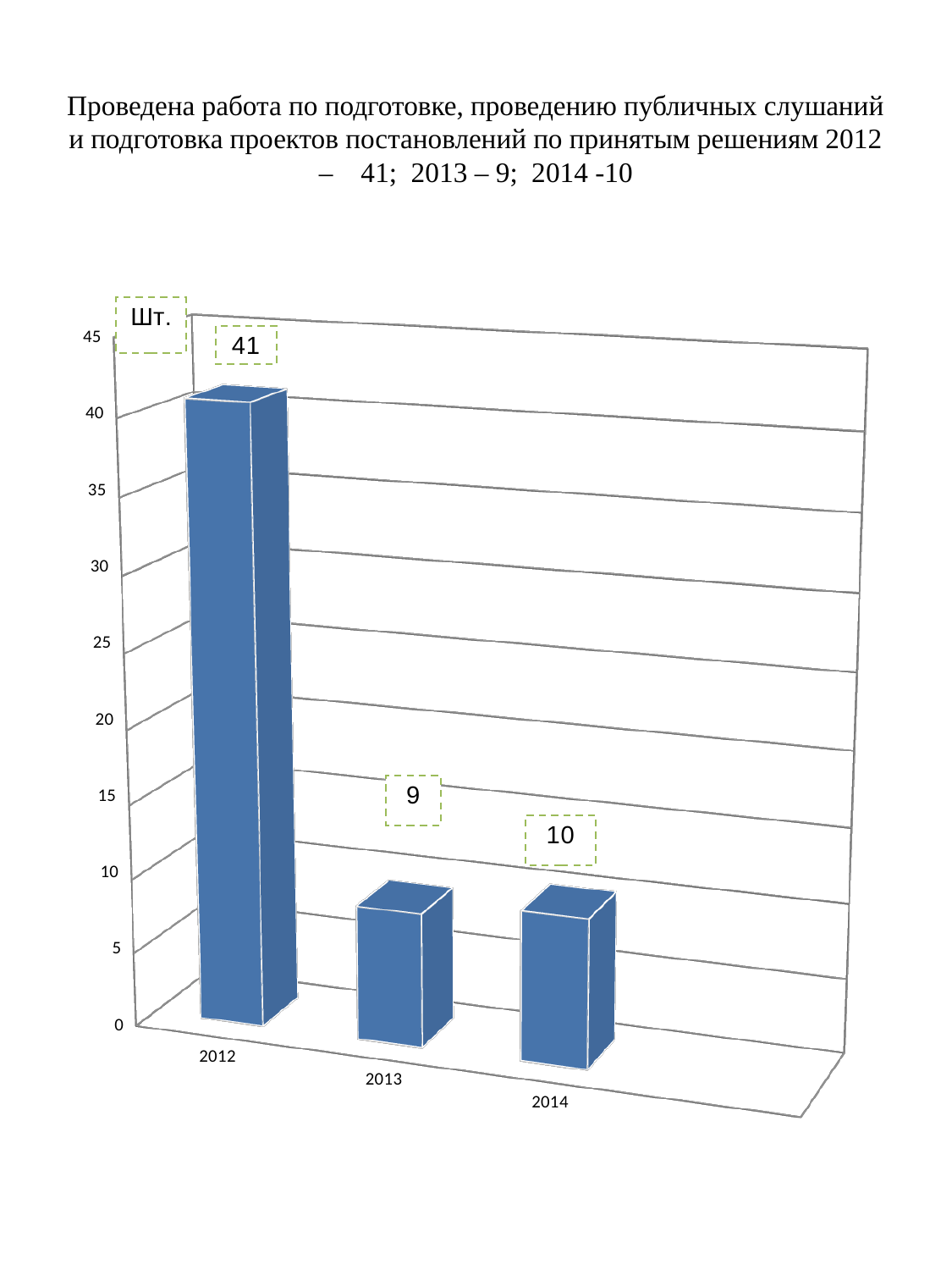
What is the value for 2014? 10 Which year has the lowest value? 2013 What kind of chart is shown on the slide? bar chart What is the value for 2012? 41 Is the value for 2012 greater or less than 40? greater Which year has the highest value? 2012 What unit label is shown at the top of the vertical axis? Шт. What is the value for 2013? 9 Which is larger, the value for 2012 or the value for 2014? 2012 What is the difference between the values for 2012 and 2013? 32 What is the difference between the values for 2014 and 2013? 1 How many years are shown on the x axis? 3